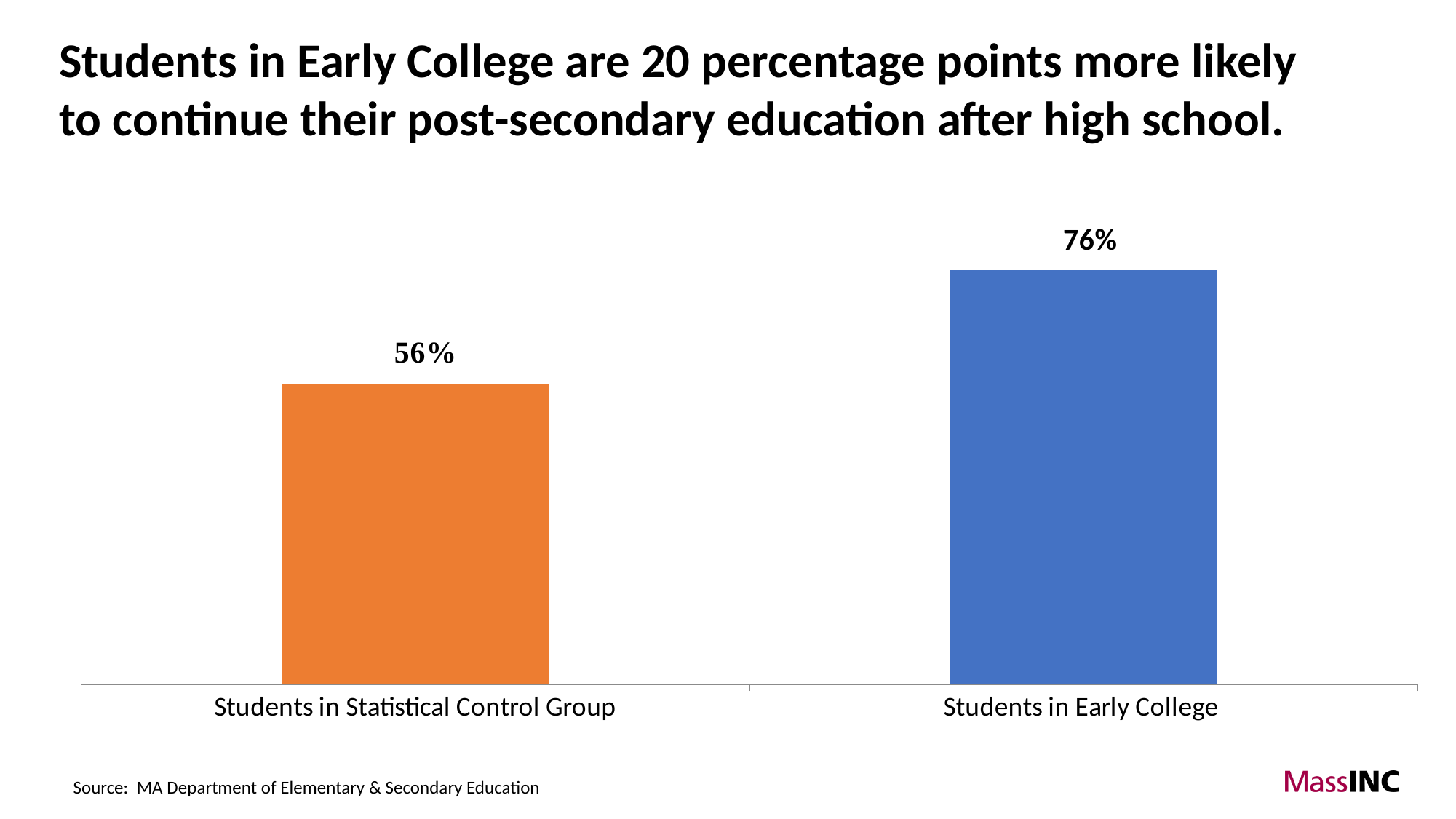
What colour is the bar for Students in Statistical Control Group? Orange What kind of chart is shown on the slide? Bar chart What is the difference between the value for Students in Early College and the value for Students in Statistical Control Group? 20 percentage points Which category has the lowest value? Students in Statistical Control Group What is the value for Students in Statistical Control Group? 56% Which is larger: the value for Students in Early College or the value for Students in Statistical Control Group? Students in Early College Which category has the highest value? Students in Early College What colour is the bar for Students in Early College? Blue What is the value for Students in Early College? 76% How many categories are shown in the chart? 2